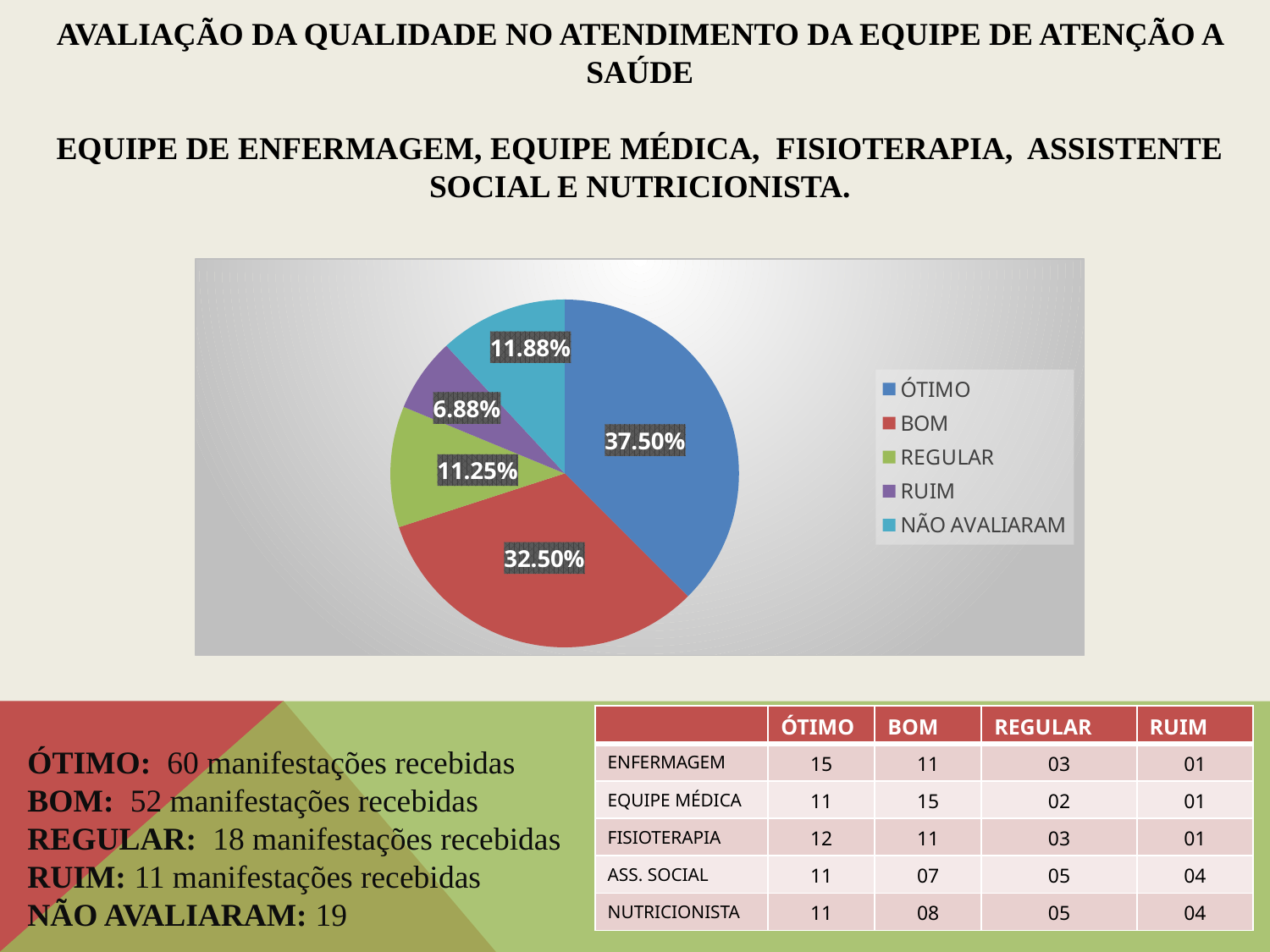
What percentage of the pie does BOM represent? 32.50% Which category has the smallest slice of the pie? RUIM What percentage of the pie does REGULAR represent? 11.25% What percentage of the pie does RUIM represent? 6.88% What percentage of the pie does ÓTIMO represent? 37.50% Which category has the largest slice of the pie? ÓTIMO Which slice is larger, REGULAR or NÃO AVALIARAM? NÃO AVALIARAM How many slices does the pie chart have? 5 What percentage of the pie does NÃO AVALIARAM represent? 11.88% What kind of chart is shown on the slide? pie chart How many entries does the legend of the pie chart list? 5 What is the difference in percentage points between the ÓTIMO and BOM slices? 5.00%